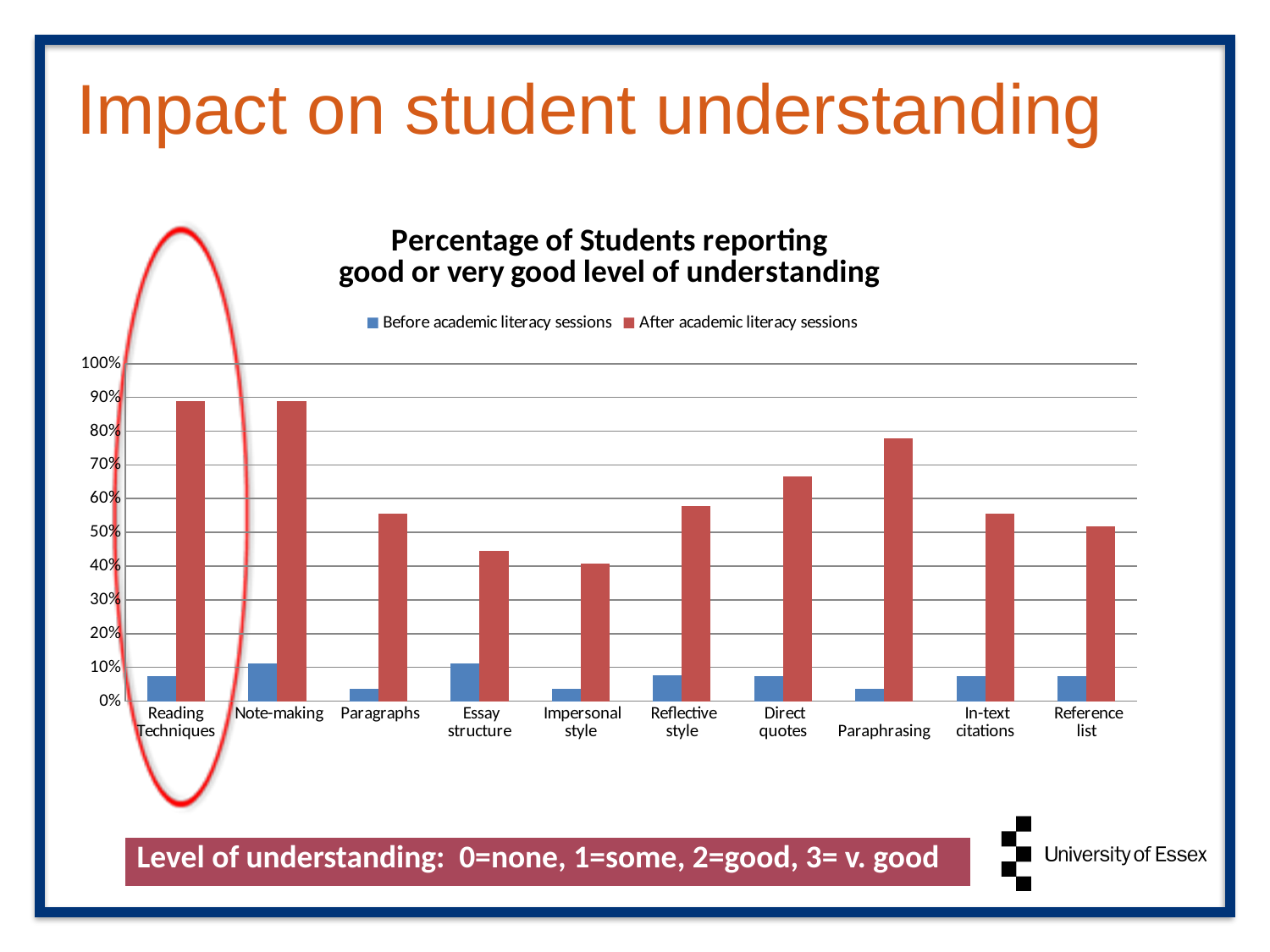
What is the title of the chart? Percentage of Students reporting good or very good level of understanding How many series does the chart's legend list? 2 What kind of chart is shown on the slide? bar chart Is the value for Paraphrasing in the After academic literacy sessions series greater or less than 70%? greater Which series is shown in red in the chart? After academic literacy sessions Is the value for Paragraphs in the Before academic literacy sessions series greater or less than 10%? less How many categories are shown on the x axis of the chart? 10 In the After academic literacy sessions series, which is larger: Reflective style or Impersonal style? Reflective style Is the value for Direct quotes in the After academic literacy sessions series greater or less than 60%? greater In the After academic literacy sessions series, which is larger: Paraphrasing or Direct quotes? Paraphrasing